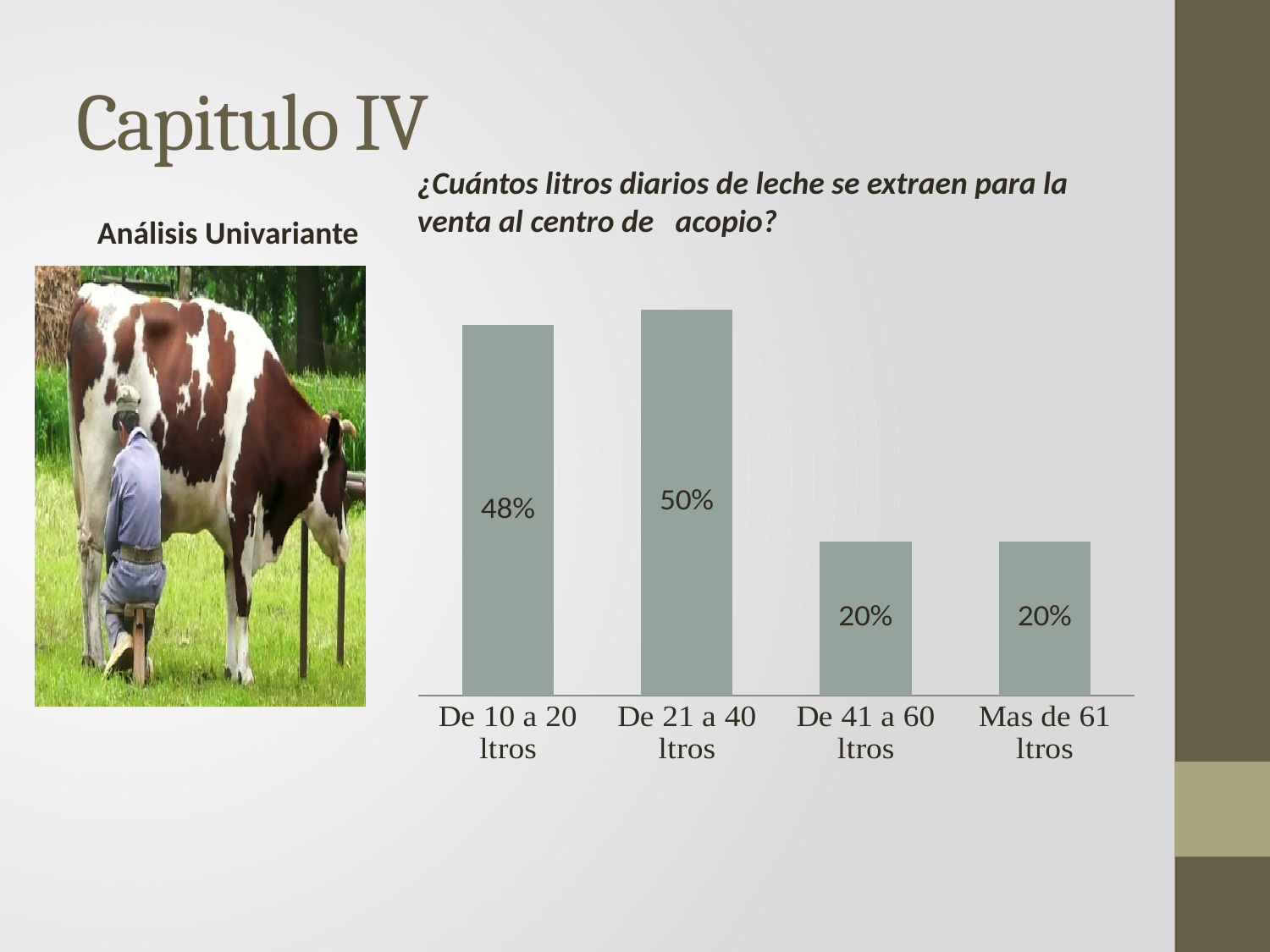
What is the value for "De 41 a 60 ltros"? 20% What question does the chart's title ask? ¿Cuántos litros diarios de leche se extraen para la venta al centro de acopio? What kind of chart is shown on the slide? bar chart What is the value for "Mas de 61 ltros"? 20% What is the difference between the values for "De 10 a 20 ltros" and "De 41 a 60 ltros"? 28% What is the value for "De 10 a 20 ltros"? 48% How many categories does the bar chart show? 4 Do the values rise or fall from "De 21 a 40 ltros" to "De 41 a 60 ltros"? fall What is the difference between the values for "De 21 a 40 ltros" and "De 10 a 20 ltros"? 2% Which category has the highest value? De 21 a 40 ltros What is the value for "De 21 a 40 ltros"? 50% Which is larger, the value for "De 21 a 40 ltros" or the value for "Mas de 61 ltros"? De 21 a 40 ltros